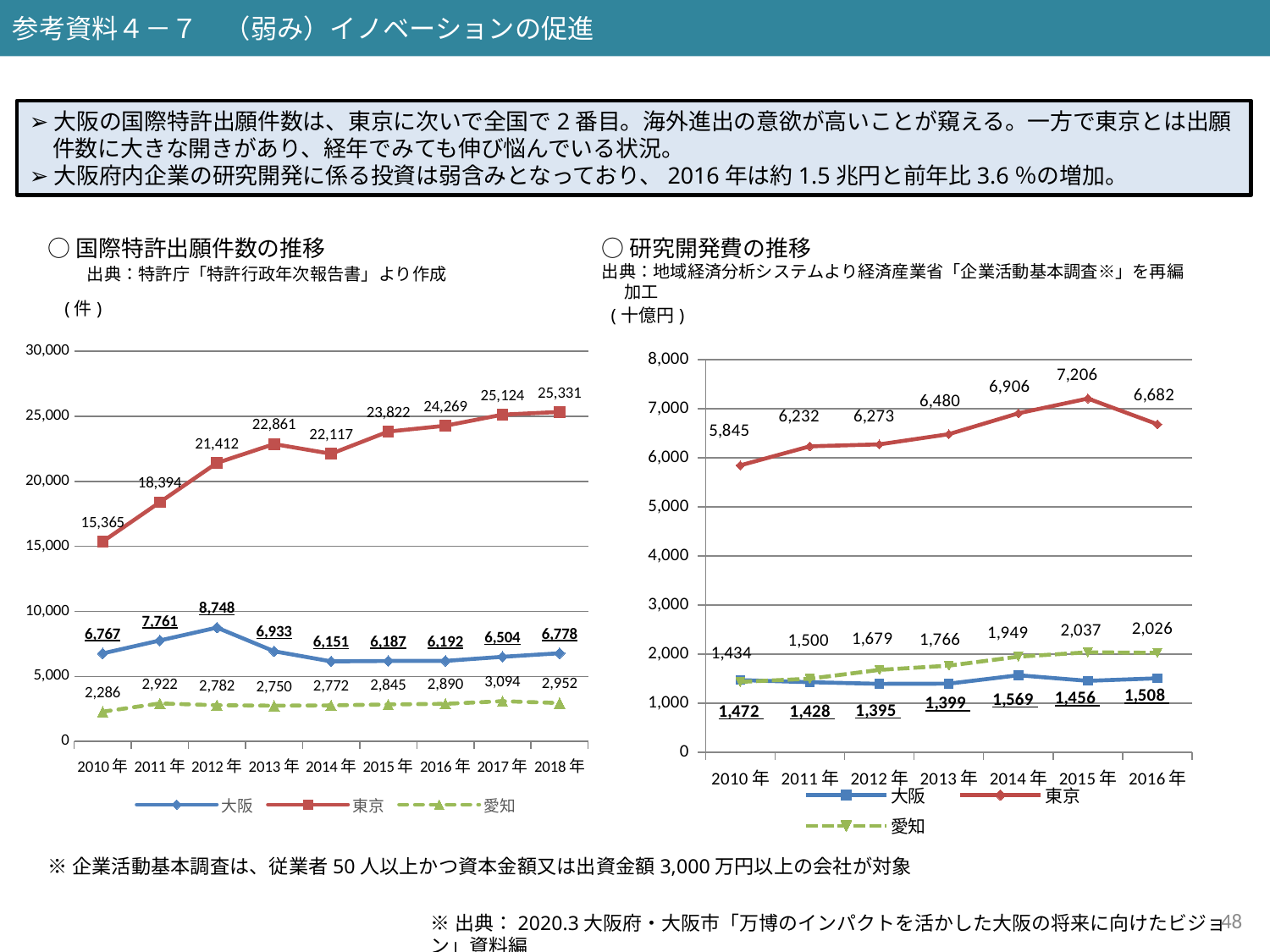
In the 国際特許出願件数の推移 chart, what is the value for 大阪 in 2012年? 8,748 In the 研究開発費の推移 chart, which is larger in 2016年, 愛知 or 大阪? 愛知 In the 研究開発費の推移 chart, what is the value for 東京 in 2015年? 7,206 In the 国際特許出願件数の推移 chart, what is the value for 東京 in 2018年? 25,331 In the 国際特許出願件数の推移 chart, in which year does 大阪 reach its highest value? 2012年 In the 研究開発費の推移 chart, what is the value for 大阪 in 2016年? 1,508 In the 国際特許出願件数の推移 chart, how many series does the legend list? 3 In the 国際特許出願件数の推移 chart, does the 東京 series generally rise or fall from 2010年 to 2018年? rise In the 研究開発費の推移 chart, in which year does 大阪 have its lowest value? 2012年 In the 研究開発費の推移 chart, how many years are plotted on the x axis? 7 What type of chart is the 研究開発費の推移 chart? line chart In the 国際特許出願件数の推移 chart, what is the difference between 東京 and 大阪 in 2018年? 18,553